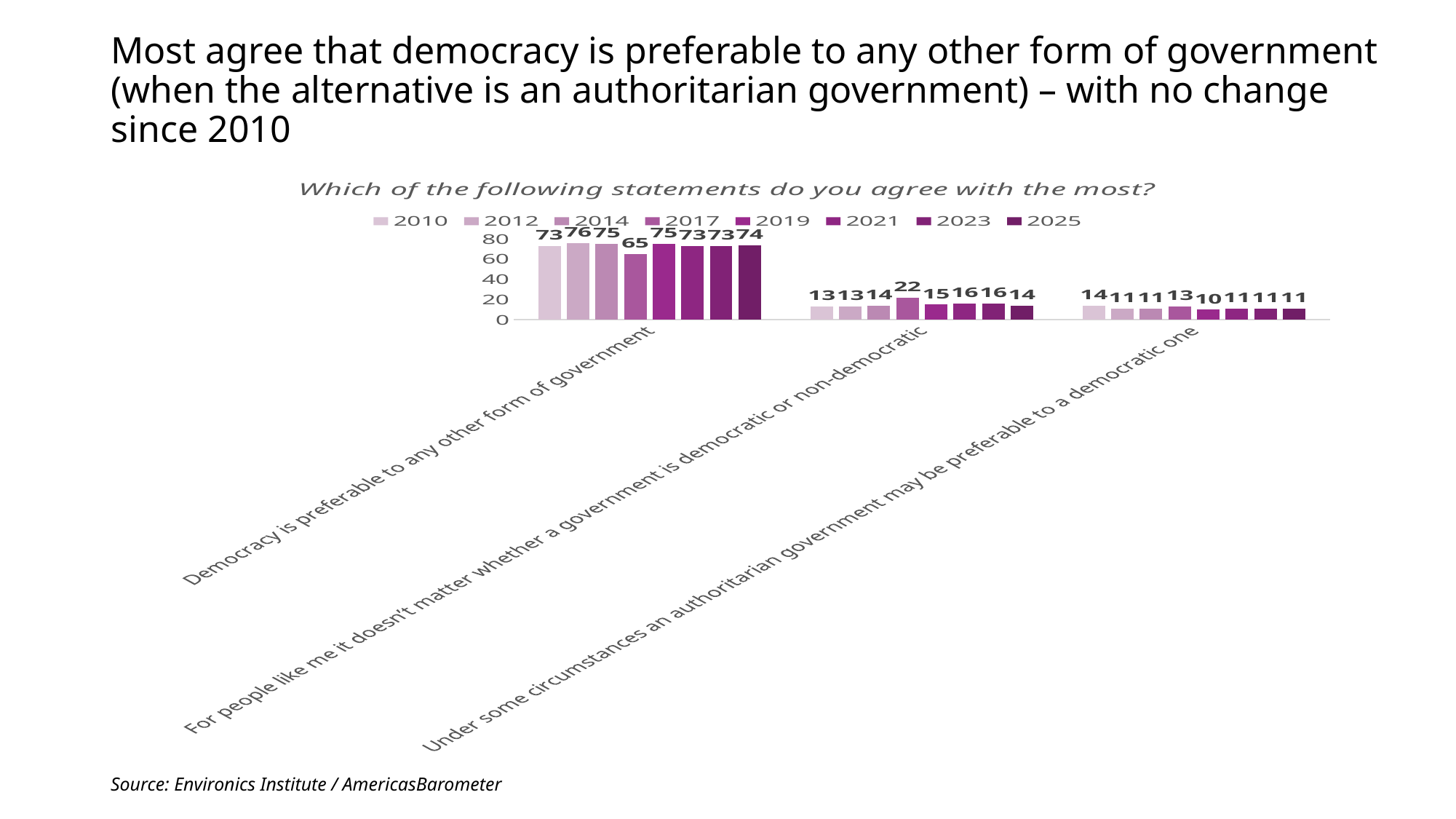
How many series does the legend list? 8 What is the title of the chart? Which of the following statements do you agree with the most? Which year has the highest value for 'Democracy is preferable to any other form of government'? 2012 What is the 2017 value for 'For people like me it doesn't matter whether a government is democratic or non-democratic'? 22 What is the 2025 value for 'Democracy is preferable to any other form of government'? 74 What kind of chart is shown on the slide? bar chart How many statement categories are shown on the x axis? 3 What is the difference between the 2012 and 2017 values for 'Democracy is preferable to any other form of government'? 11 What is the 2017 value for 'Democracy is preferable to any other form of government'? 65 Which year has the lowest value for 'Democracy is preferable to any other form of government'? 2017 What is the 2019 value for 'Under some circumstances an authoritarian government may be preferable to a democratic one'? 10 Which is larger in 2010: the value for 'For people like me it doesn't matter whether a government is democratic or non-democratic' or the value for 'Under some circumstances an authoritarian government may be preferable to a democratic one'? Under some circumstances an authoritarian government may be preferable to a democratic one